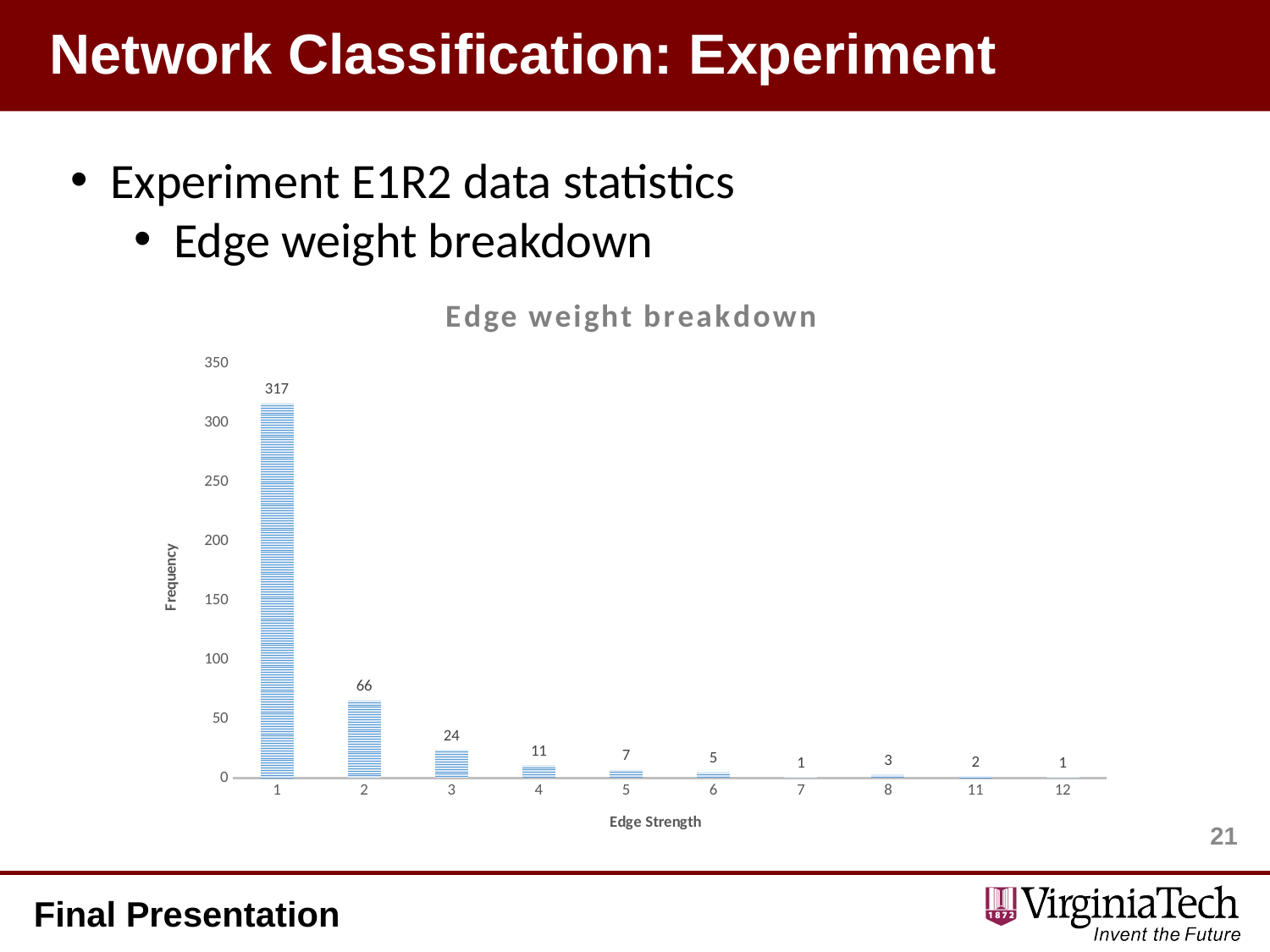
What is the frequency for edge strength 8? 3 What is the title of the chart? Edge weight breakdown What is the difference in frequency between edge strength 3 and edge strength 4? 13 Which has a higher frequency, edge strength 5 or edge strength 6? Edge strength 5 What kind of chart is shown on the slide? Bar chart What is the frequency for edge strength 3? 24 Which edge strength has the highest frequency? 1 What is the frequency for edge strength 2? 66 What is the difference in frequency between edge strength 1 and edge strength 2? 251 How many edge strength categories are shown on the x axis? 10 What is the frequency for edge strength 1? 317 Is the frequency for edge strength 1 greater or less than 300? greater